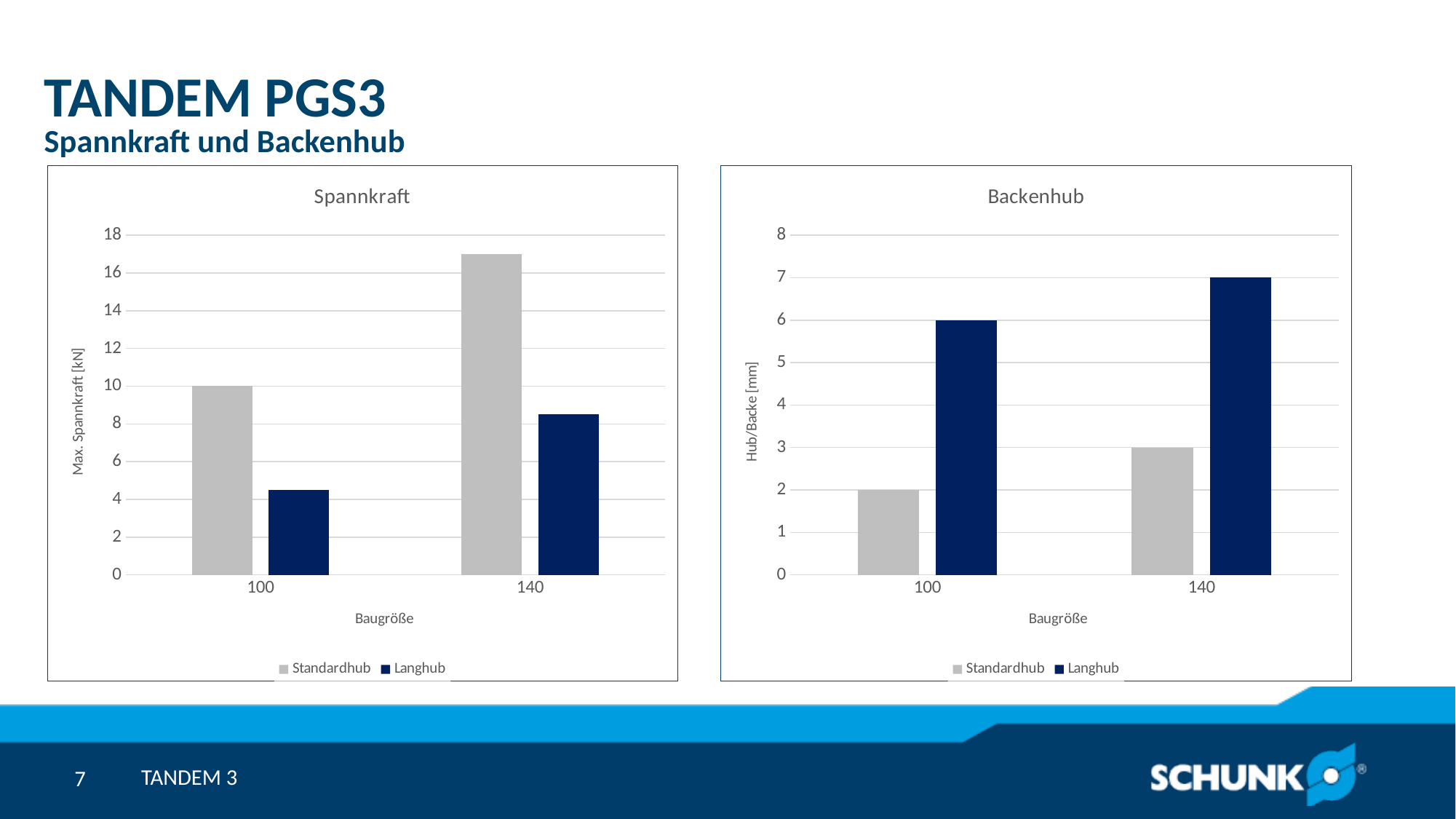
In the Backenhub chart, how many series does the legend list? 2 In the Backenhub chart, which series has the lowest value for Baugröße 140? Standardhub What kind of chart is the Spannkraft chart? Bar chart In the Backenhub chart, what is the difference between the Langhub and Standardhub values for Baugröße 100? 4 In the Spannkraft chart, is the Standardhub value for Baugröße 140 greater or less than 16? greater In the Spannkraft chart, which Baugröße has the highest Standardhub value? 140 In the Backenhub chart, what is the Standardhub value for Baugröße 100? 2 In the Spannkraft chart, is the Langhub value for Baugröße 140 greater or less than 10? less In the Spannkraft chart, which is larger for Baugröße 100: Standardhub or Langhub? Standardhub In the Backenhub chart, what is the Langhub value for Baugröße 140? 7 What is the y-axis label of the Backenhub chart? Hub/Backe [mm] In the Spannkraft chart, what is the Standardhub value for Baugröße 100? 10